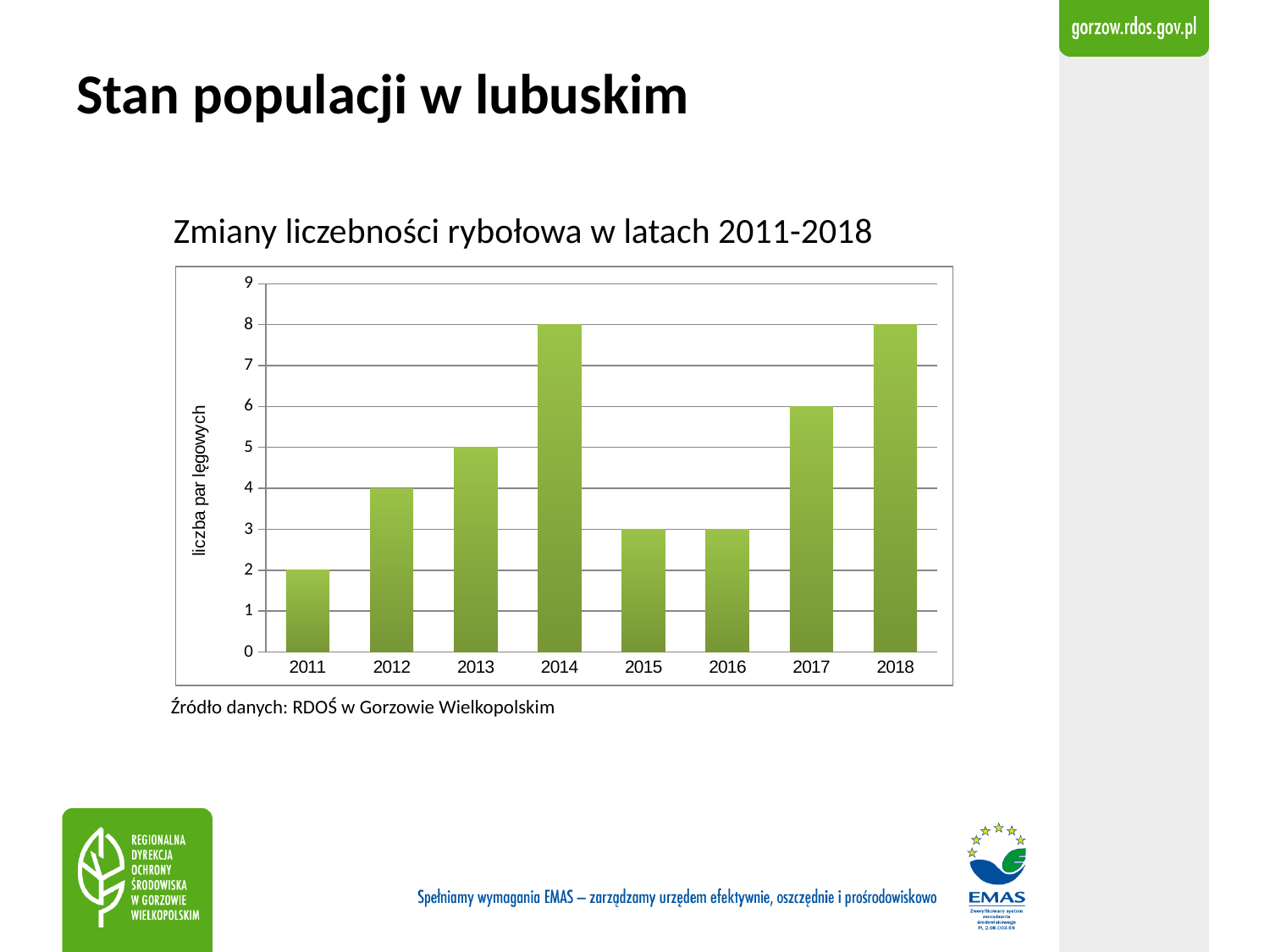
Which is larger, the value for 2012 or the value for 2016? 2012 What is the title of the chart? Zmiany liczebności rybołowa w latach 2011-2018 What is the difference between the values for 2014 and 2015? 5 What is the value (liczba par lęgowych) for 2011? 2 Which year has the lowest value? 2011 What is the value for 2014? 8 What kind of chart is shown on the slide? bar chart What is the value for 2013? 5 What is the value for 2017? 6 How many years (categories) are shown on the x axis of the chart? 8 What is the label of the y axis? liczba par lęgowych Is the value for 2018 greater or less than 7? greater